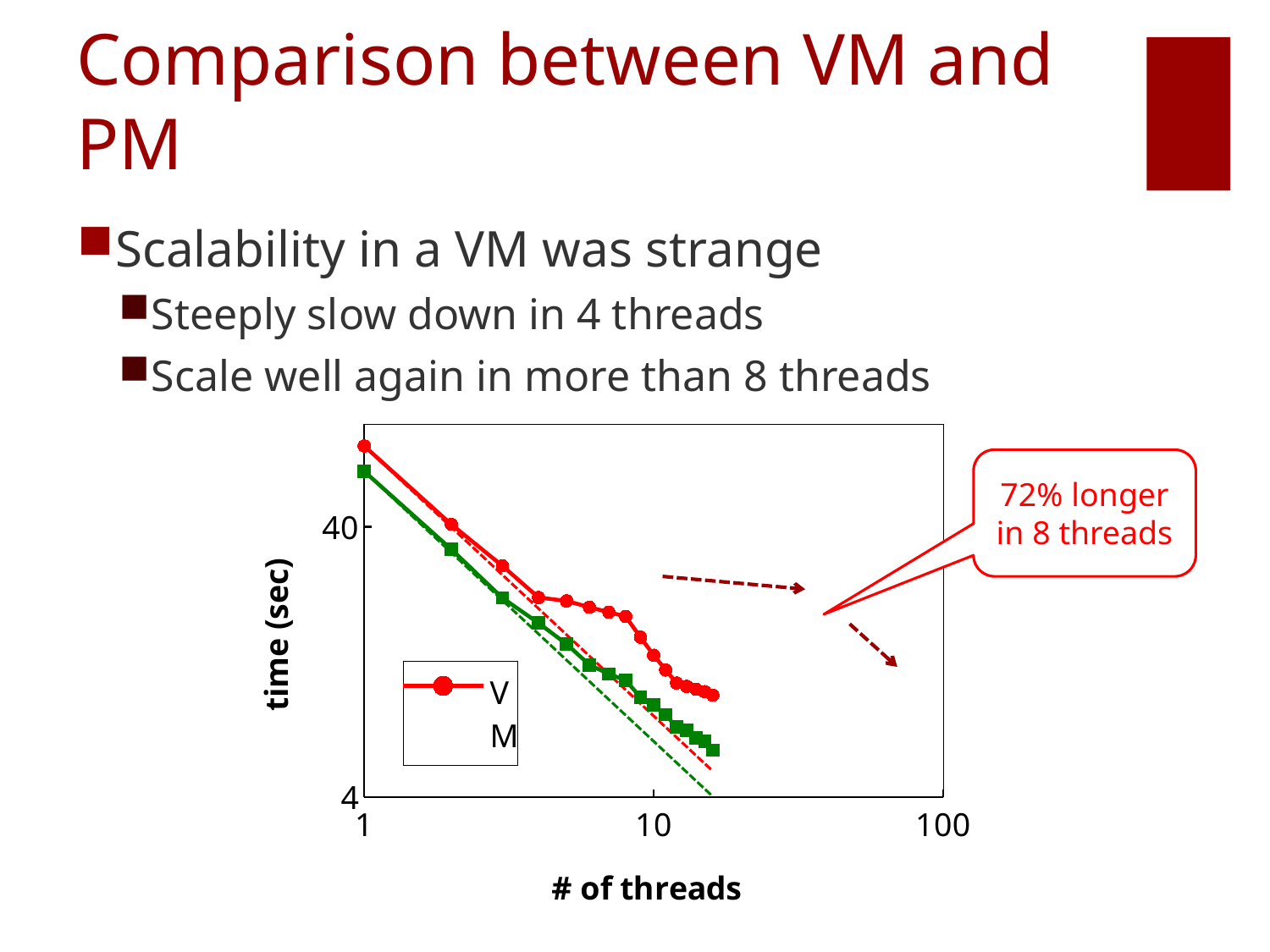
According to the callout on the chart, how much longer is the VM time in 8 threads? 72% longer Do the plotted times rise or fall as the number of threads increases? fall What is the label of the y axis? time (sec) What is the label of the x axis? # of threads What kind of chart is shown on the slide? line chart How many solid data series are plotted on the chart? 2 Is the value for VM at 8 threads greater or less than 40? less At 8 threads, which series has the larger time: VM or the green square series? VM At 1 thread, which series has the larger time: VM or the green square series? VM Is the value for VM at 1 thread greater or less than 40? greater Is the value for VM at 16 threads greater or less than 40? less